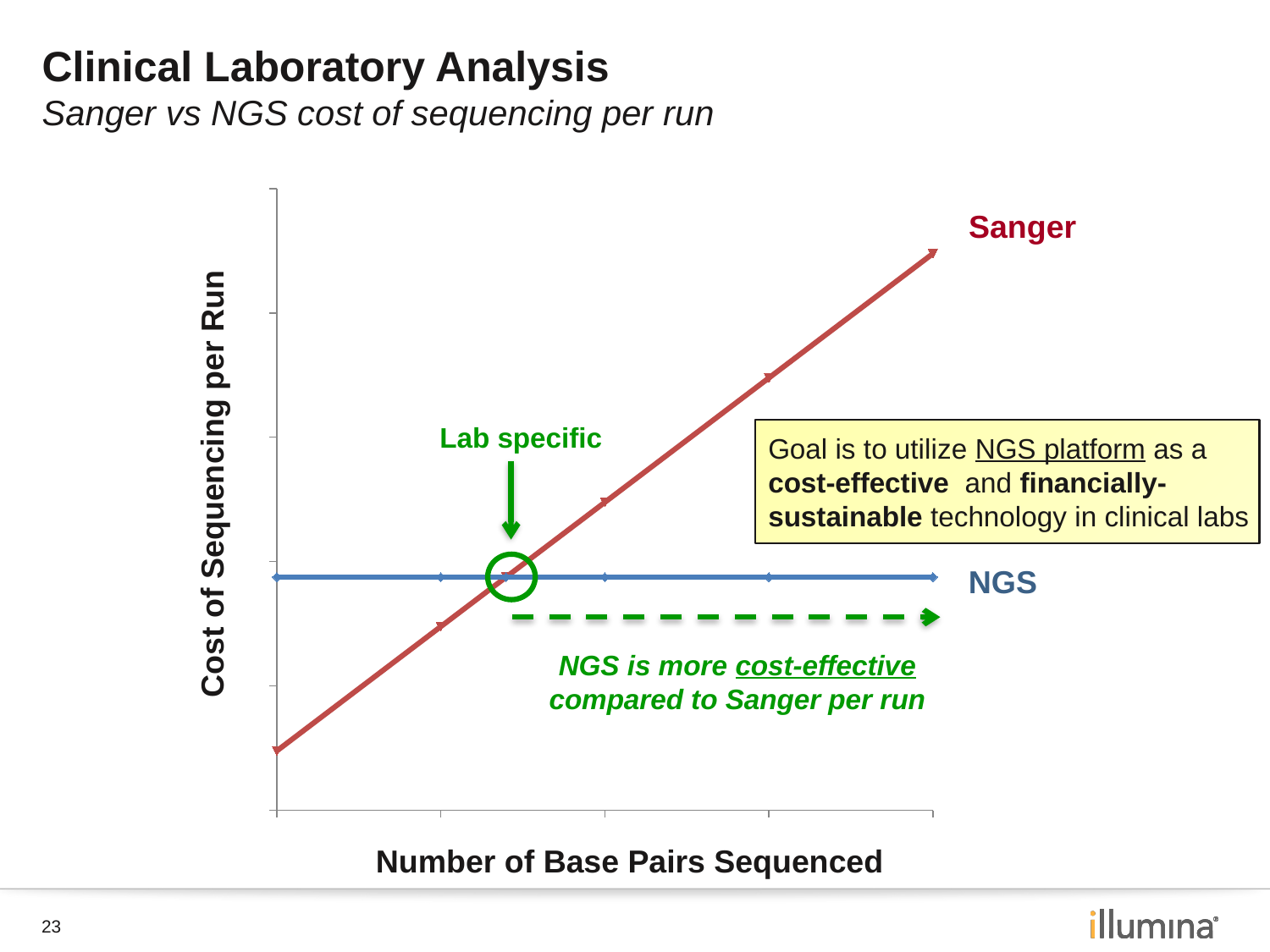
Which two series are plotted on the chart? Sanger and NGS At the rightmost point on the x axis, which series has the higher cost of sequencing per run, Sanger or NGS? Sanger Does the Sanger line rise or fall as the number of base pairs sequenced increases? Rises What is the label of the x axis? Number of Base Pairs Sequenced How many series are plotted on the chart? 2 Which series reaches the highest cost of sequencing per run anywhere on the chart? Sanger How many data points are plotted on the NGS line? 6 What kind of chart is shown on the slide? Line chart Does the NGS line rise, fall, or stay flat as the number of base pairs sequenced increases? Stays flat How many data points are plotted on the Sanger line? 6 At the leftmost point on the x axis, which series has the lower cost of sequencing per run, Sanger or NGS? Sanger Which series has the lowest cost of sequencing per run anywhere on the chart? Sanger